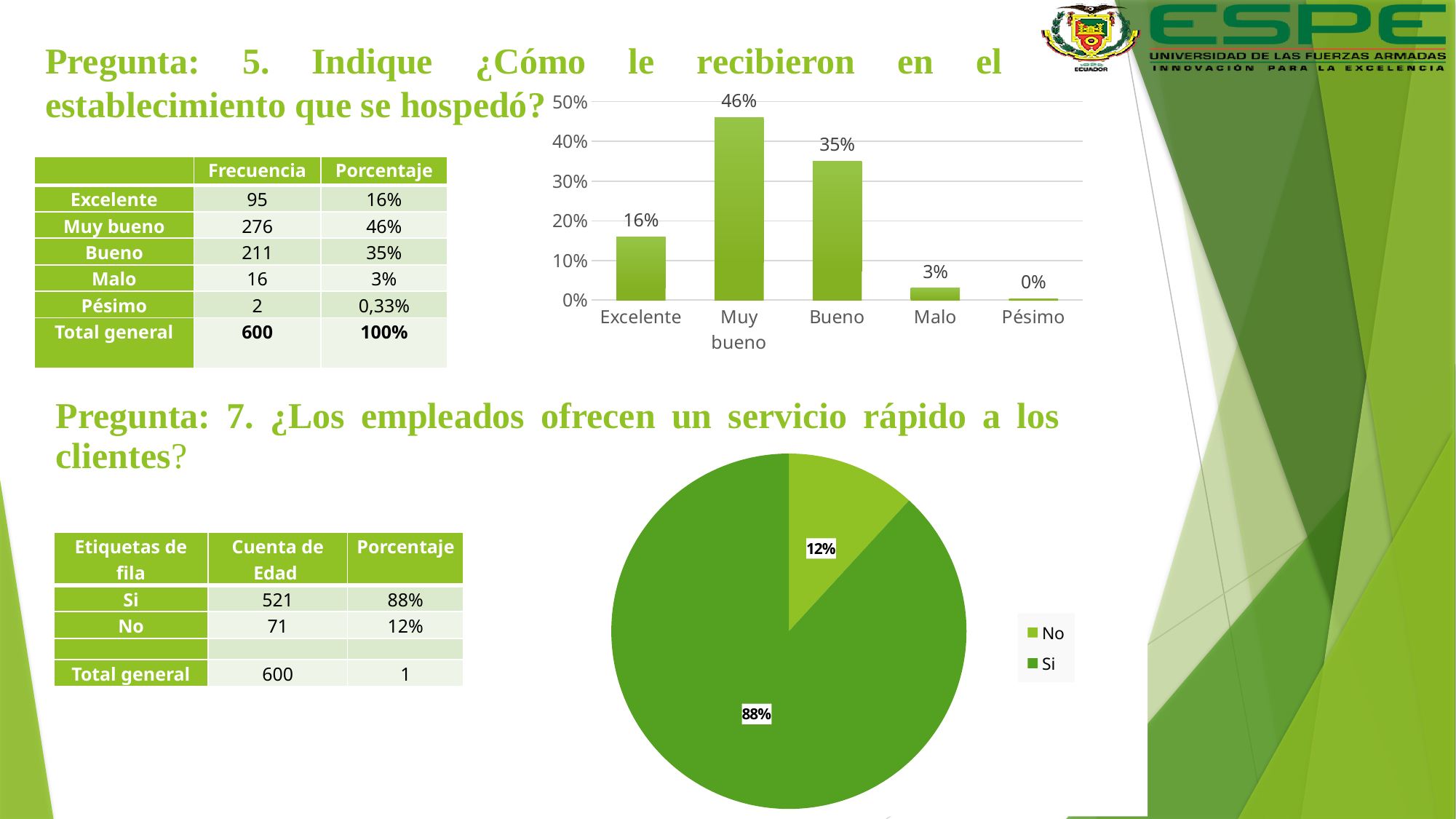
In the bar chart at the top of the slide, which category has the highest value? Muy bueno In the bar chart at the top of the slide, which category has the lowest value? Pésimo How many entries does the legend of the pie chart at the bottom of the slide list? 2 In the pie chart at the bottom of the slide, what share does the Si slice have? 88% What kind of chart is the chart at the top of the slide? Bar chart In the pie chart at the bottom of the slide, what share does the No slice have? 12% In the bar chart at the top of the slide, what is the difference between the values for Muy bueno and Bueno? 11% In the bar chart at the top of the slide, what is the value for Muy bueno? 46% In the bar chart at the top of the slide, what is the value for Malo? 3% In the bar chart at the top of the slide, what is the value for Bueno? 35% How many categories are shown in the bar chart at the top of the slide? 5 In the bar chart at the top of the slide, which is larger, the value for Excelente or the value for Bueno? Bueno